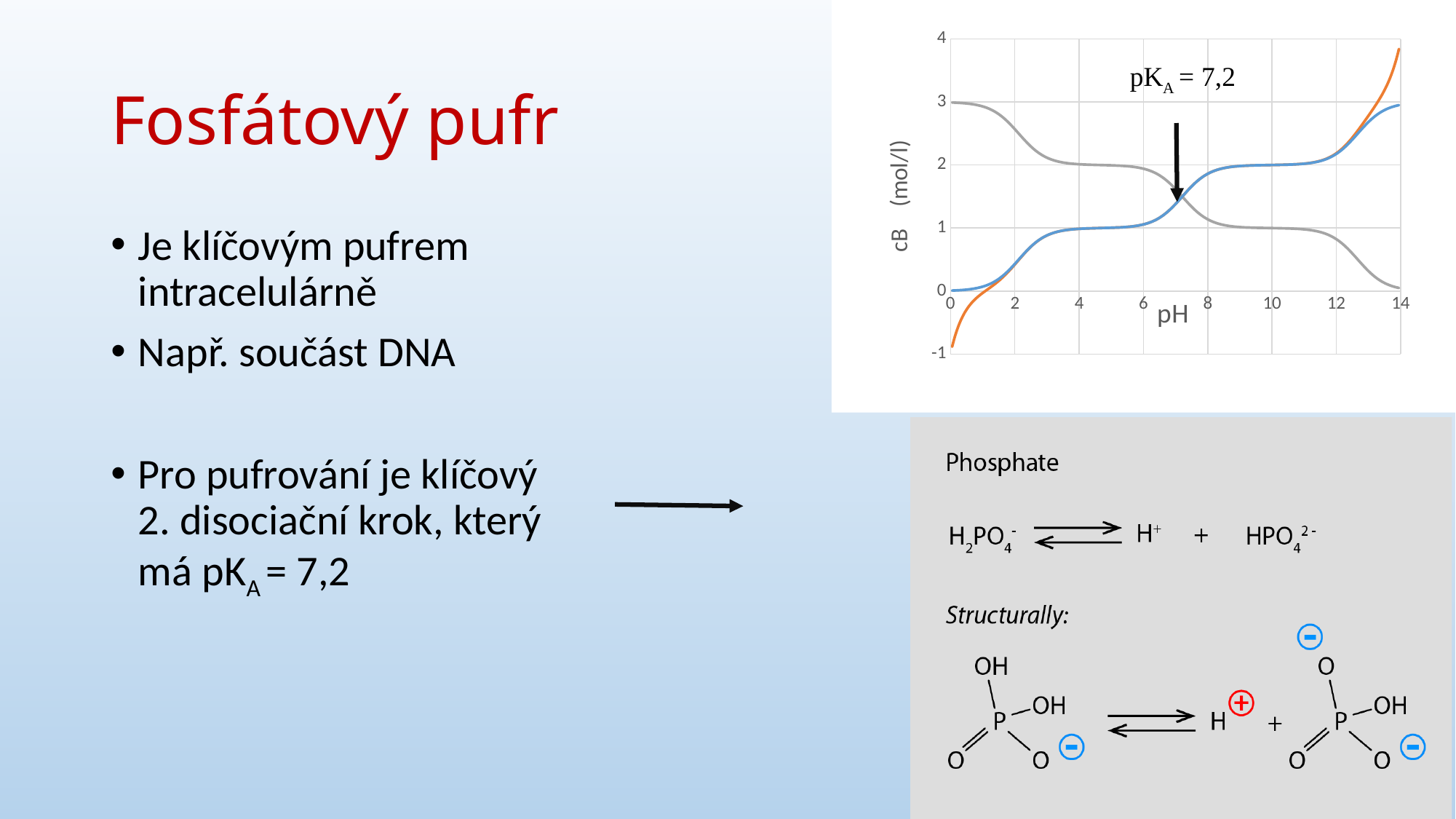
What value does the annotation with the arrow on the chart give for pKA? 7,2 Is the value of the orange curve at pH 0 greater or less than 0? less What is the label of the x axis of the chart? pH At pH 14, which curve has the higher value, the orange curve or the grey curve? orange curve What is the label of the y axis of the chart? cB (mol/l) Does the grey curve rise or fall as pH increases along the x axis? falls Does the blue curve rise or fall as pH increases along the x axis? rises How many curves are plotted on the chart? 3 Is the value of the grey curve at pH 0 greater or less than 2? greater Is the value of the orange curve at pH 14 greater or less than 3? greater What is the highest pH value marked on the x axis of the chart? 14 What kind of chart is shown on the slide? line chart